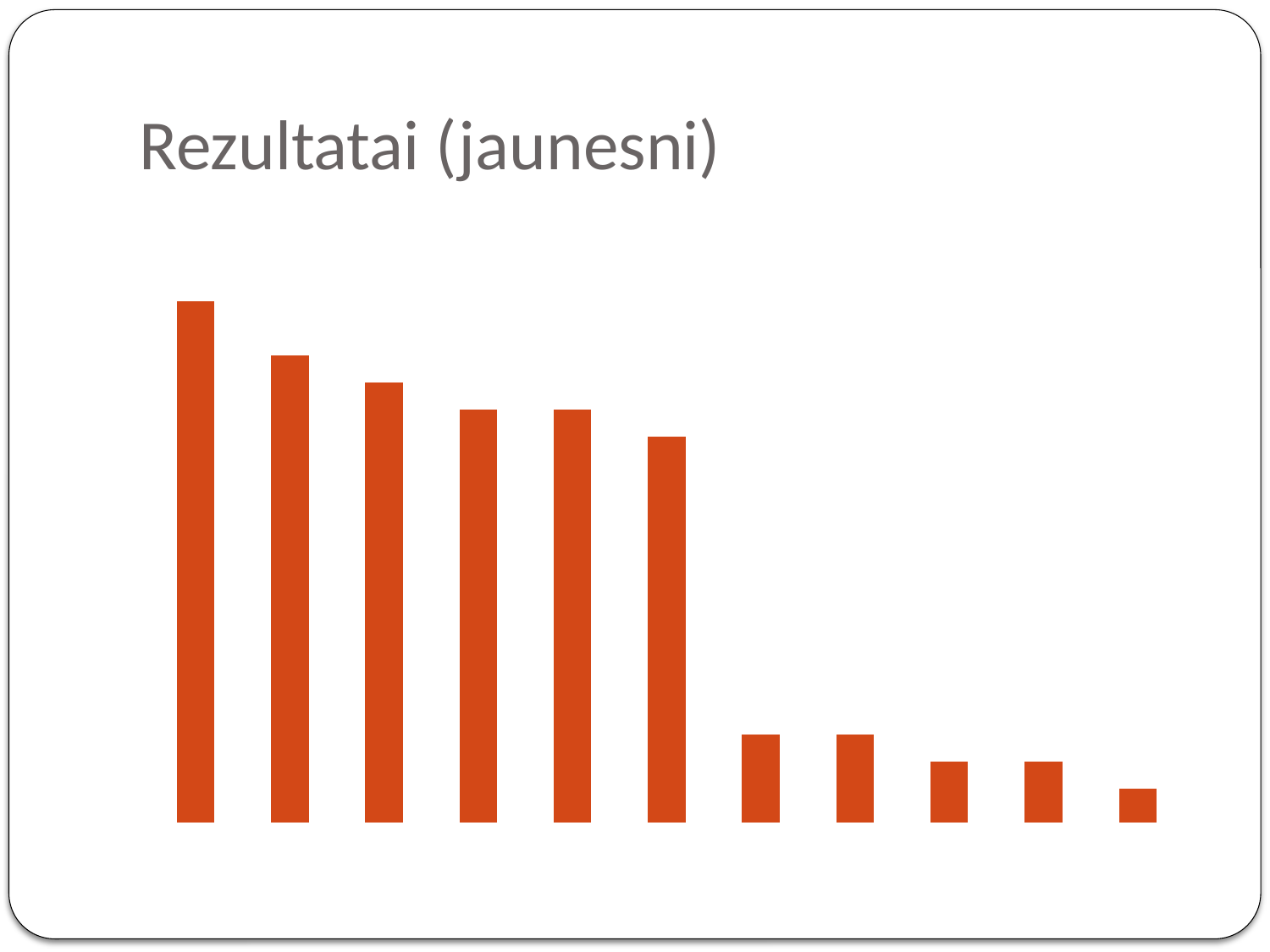
What colour are the bars in the chart? orange Which bar is the shortest in the chart? the last (rightmost) bar What kind of chart is shown on the slide? bar chart Which bar is the tallest in the chart? the first (leftmost) bar How many bars does the chart contain? 11 What is the title of the slide containing the chart? Rezultatai (jaunesni) Do the bar values rise or fall from left to right across the chart? fall How many bars are noticeably taller than the rest (the tall group on the left)? 6 Which is taller, the second bar from the left or the sixth bar from the left? the second bar Which is taller, the seventh bar from the left or the ninth bar from the left? the seventh bar